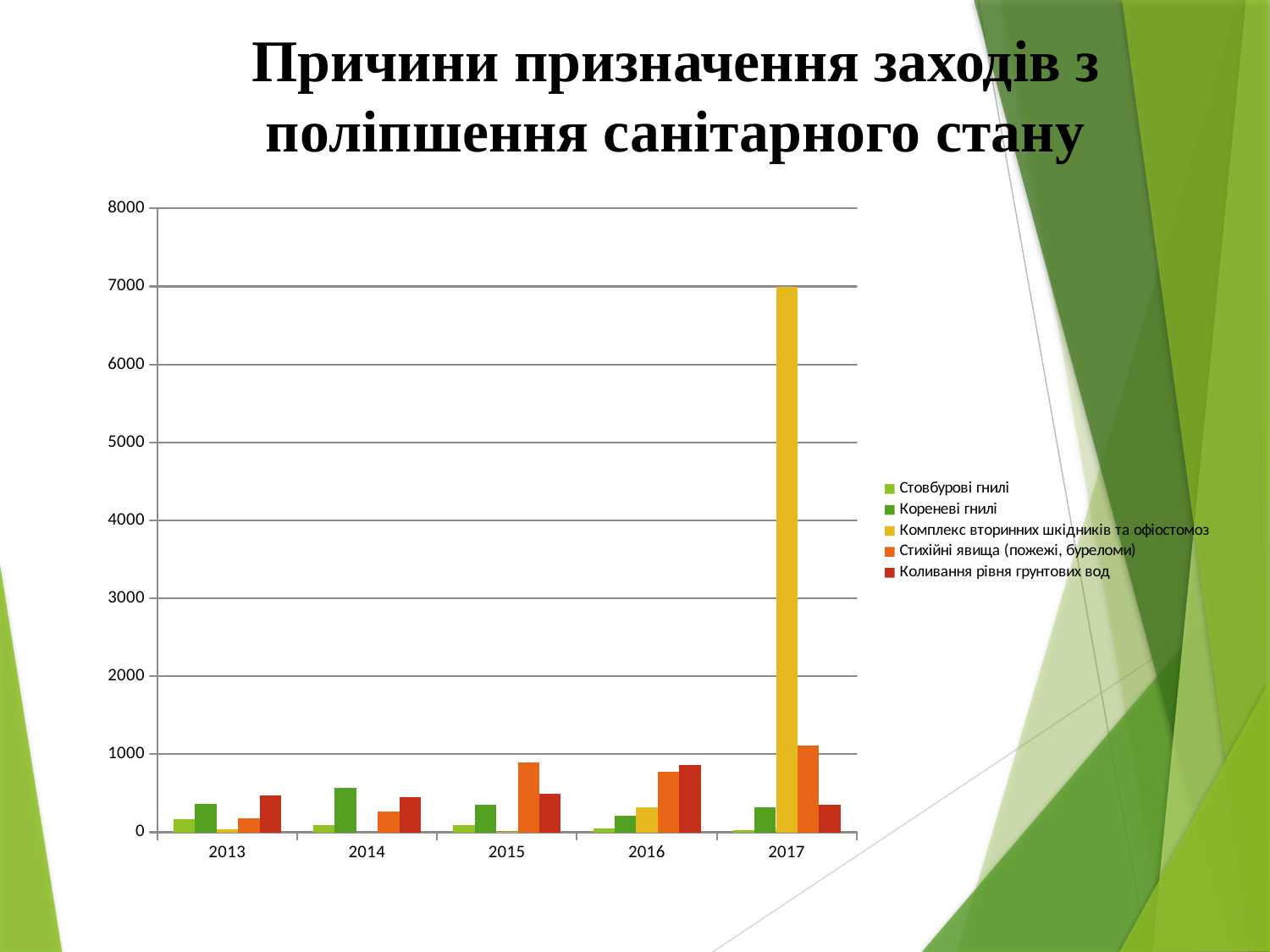
What is the title of the slide containing the chart? Причини призначення заходів з поліпшення санітарного стану In which year is the value for "Стихійні явища (пожежі, буреломи)" highest? 2017 How many series does the chart legend list? 5 In 2015, which is larger: "Стихійні явища (пожежі, буреломи)" or "Коливання рівня грунтових вод"? Стихійні явища (пожежі, буреломи) Is the value for "Комплекс вторинних шкідників та офіостомоз" in 2017 greater or less than 6000? greater What kind of chart is shown on the slide? bar chart Which series has the highest value in 2017? Комплекс вторинних шкідників та офіостомоз In which year is the value for "Комплекс вторинних шкідників та офіостомоз" highest? 2017 How many years are shown on the x axis of the chart? 5 Is the value for "Кореневі гнилі" in 2014 greater or less than 1000? less Is the value for "Стихійні явища (пожежі, буреломи)" in 2015 greater or less than 1000? less